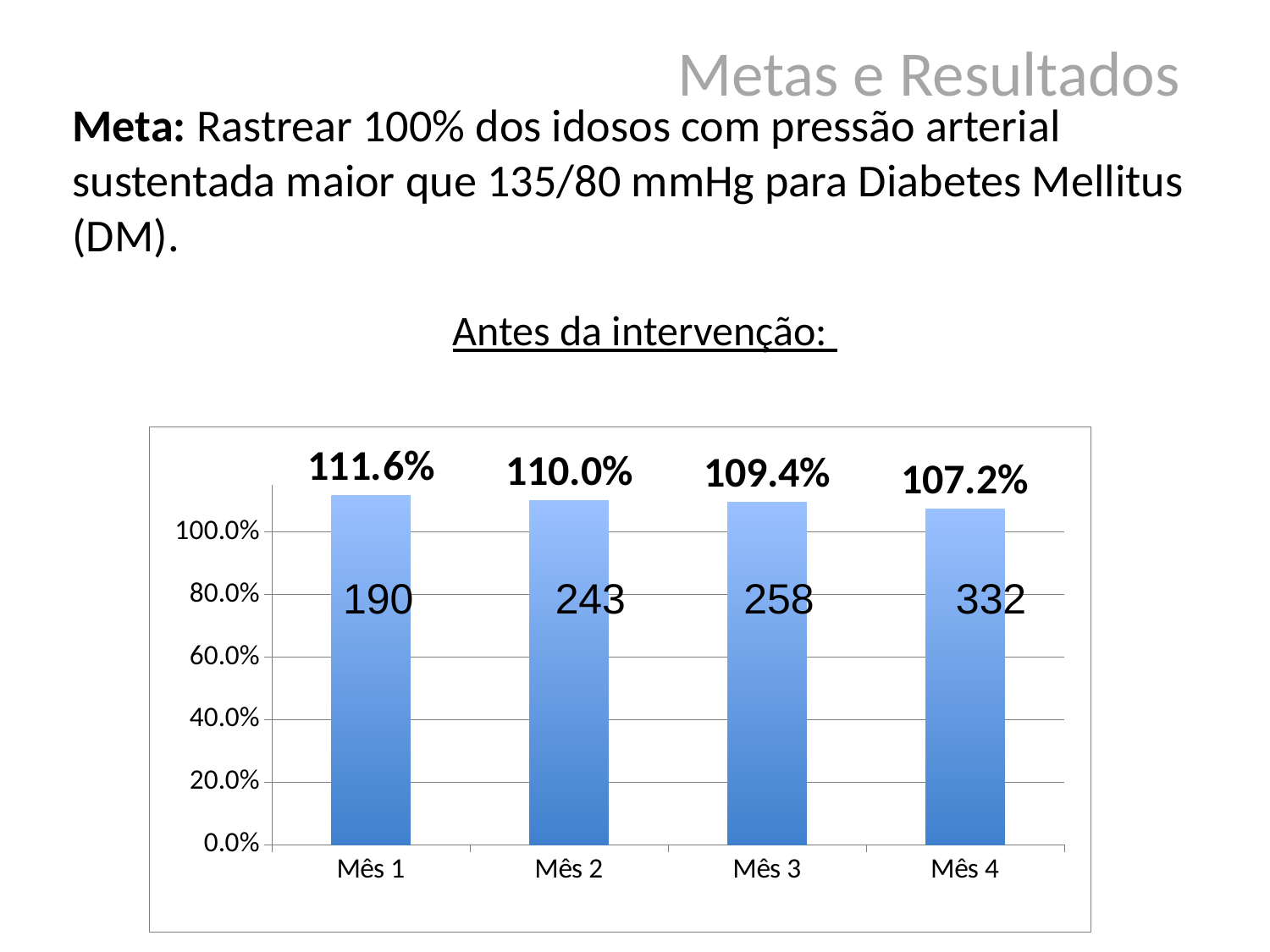
Which month has the highest percentage value? Mês 1 What is the percentage value shown for Mês 1? 111.6% Which has a larger percentage value, Mês 2 or Mês 3? Mês 2 What is the percentage value shown for Mês 4? 107.2% What number is printed inside the bar for Mês 2? 243 What is the difference between the percentage values for Mês 1 and Mês 4? 4.4% How many months are shown on the x axis? 4 Is the value for Mês 4 greater or less than 100.0%? greater What is the difference between the numbers printed inside the bars for Mês 4 and Mês 1? 142 Which month has the lowest percentage value? Mês 4 What number is printed inside the bar for Mês 3? 258 Do the percentage values rise or fall from Mês 1 to Mês 4? fall